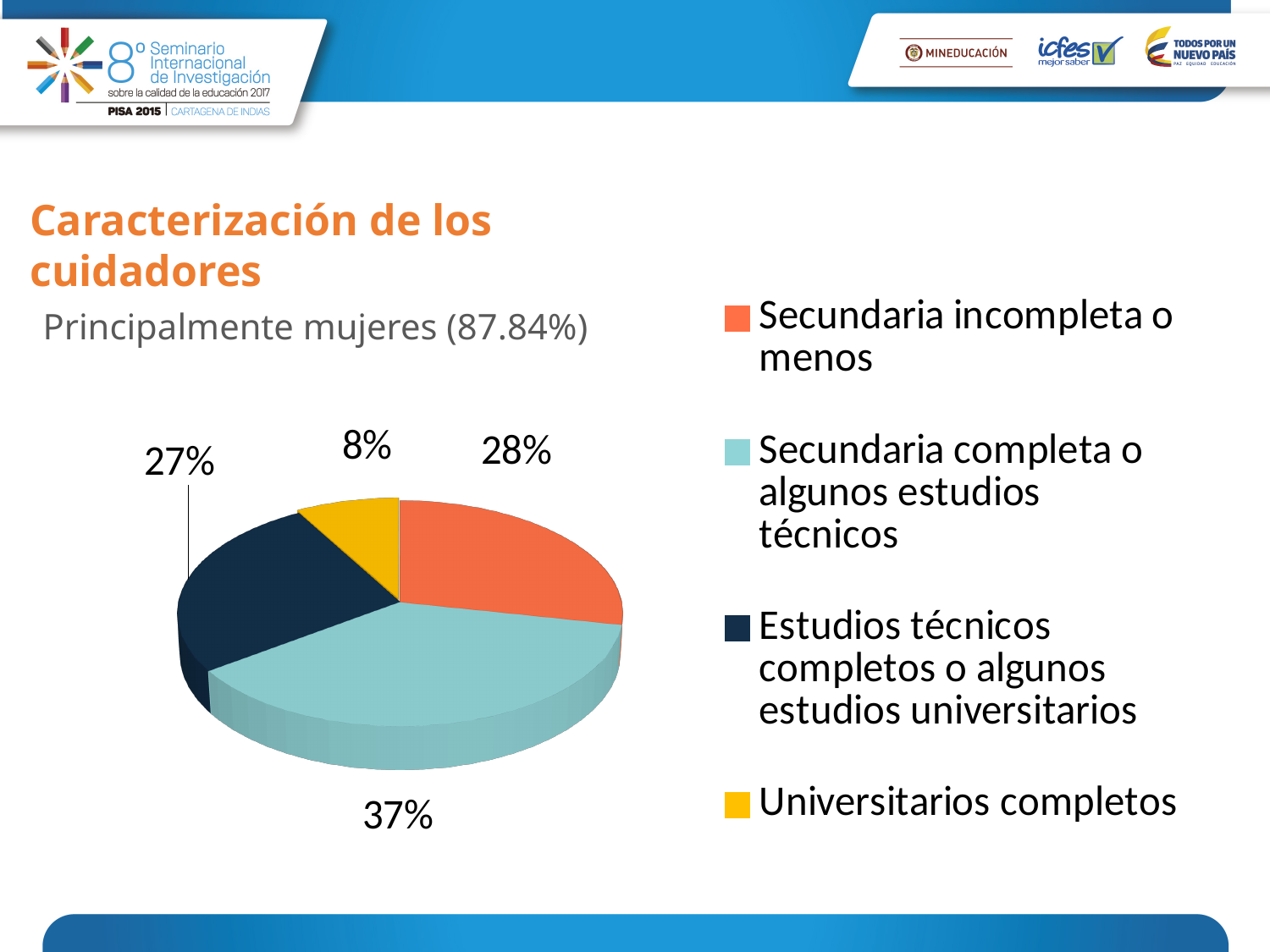
What share of the pie does "Secundaria completa o algunos estudios técnicos" represent? 37% What share of the pie does "Secundaria incompleta o menos" represent? 28% What is the difference in percentage points between "Secundaria incompleta o menos" and "Estudios técnicos completos o algunos estudios universitarios"? 1 percentage point What is the difference in percentage points between "Secundaria completa o algunos estudios técnicos" and "Universitarios completos"? 29 percentage points What kind of chart is shown on the slide? pie chart What share of the pie does "Estudios técnicos completos o algunos estudios universitarios" represent? 27% Which is larger: the slice for "Secundaria incompleta o menos" or the slice for "Universitarios completos"? Secundaria incompleta o menos How many categories does the pie chart have? 4 Which category has the largest slice of the pie? Secundaria completa o algunos estudios técnicos Which category has the smallest slice of the pie? Universitarios completos What share of the pie does "Universitarios completos" represent? 8% What colour is the slice for "Universitarios completos"? yellow